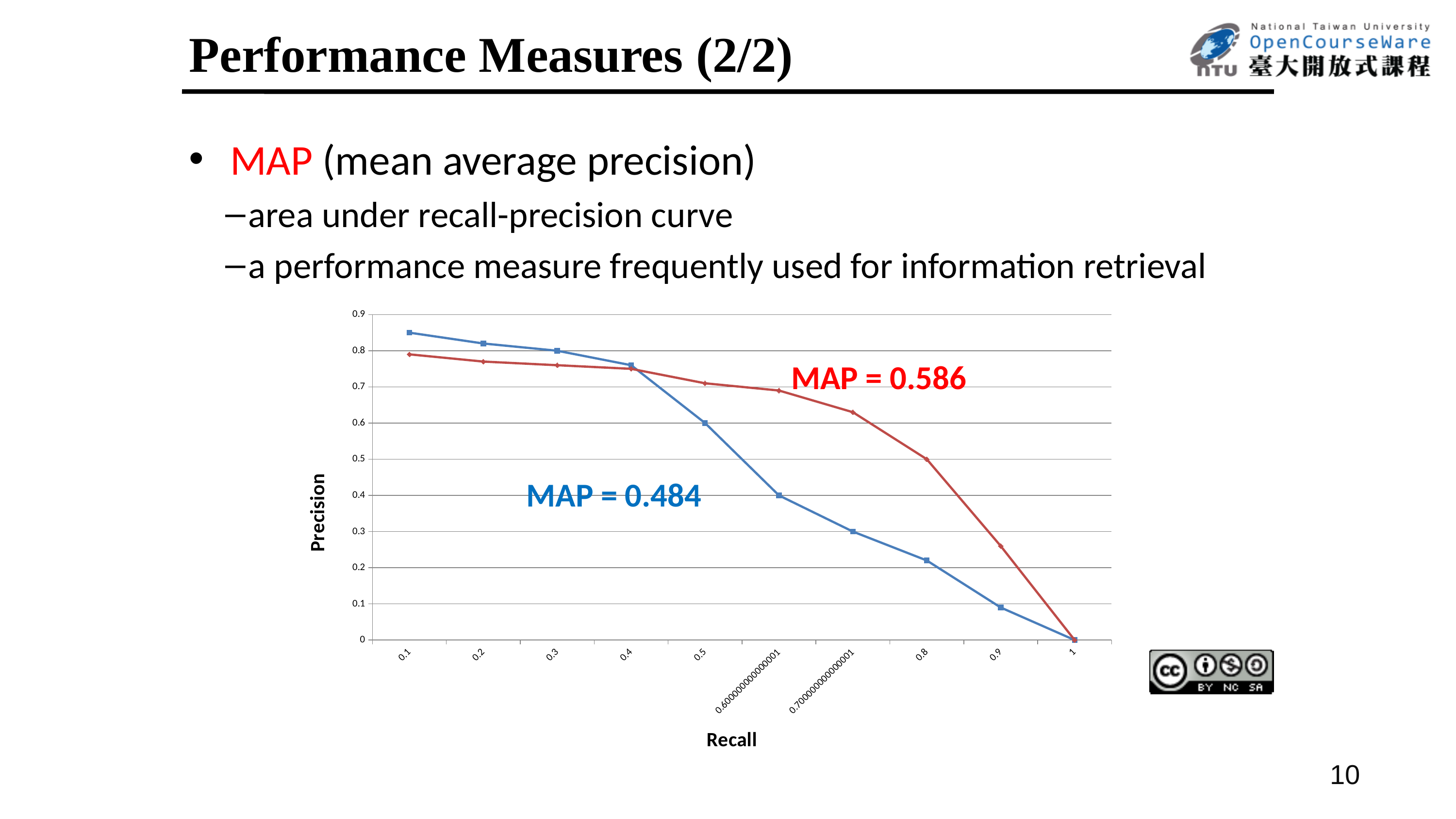
What MAP value is annotated for the red line in the chart? MAP = 0.586 At recall 0.8, which line has the higher precision, the red line or the blue line? red line What kind of chart is shown on the slide? line chart What is the precision of the red line at recall 0.8? 0.5 How many recall values are marked along the x axis of the chart? 10 What is the precision of the blue line at recall 0.5? 0.6 Do the precision values of the blue line rise or fall as recall increases along the x axis? fall What is the precision of the blue line at recall 0.3? 0.8 What is the precision of both lines at recall 1? 0 How many lines (series) are plotted in the chart? 2